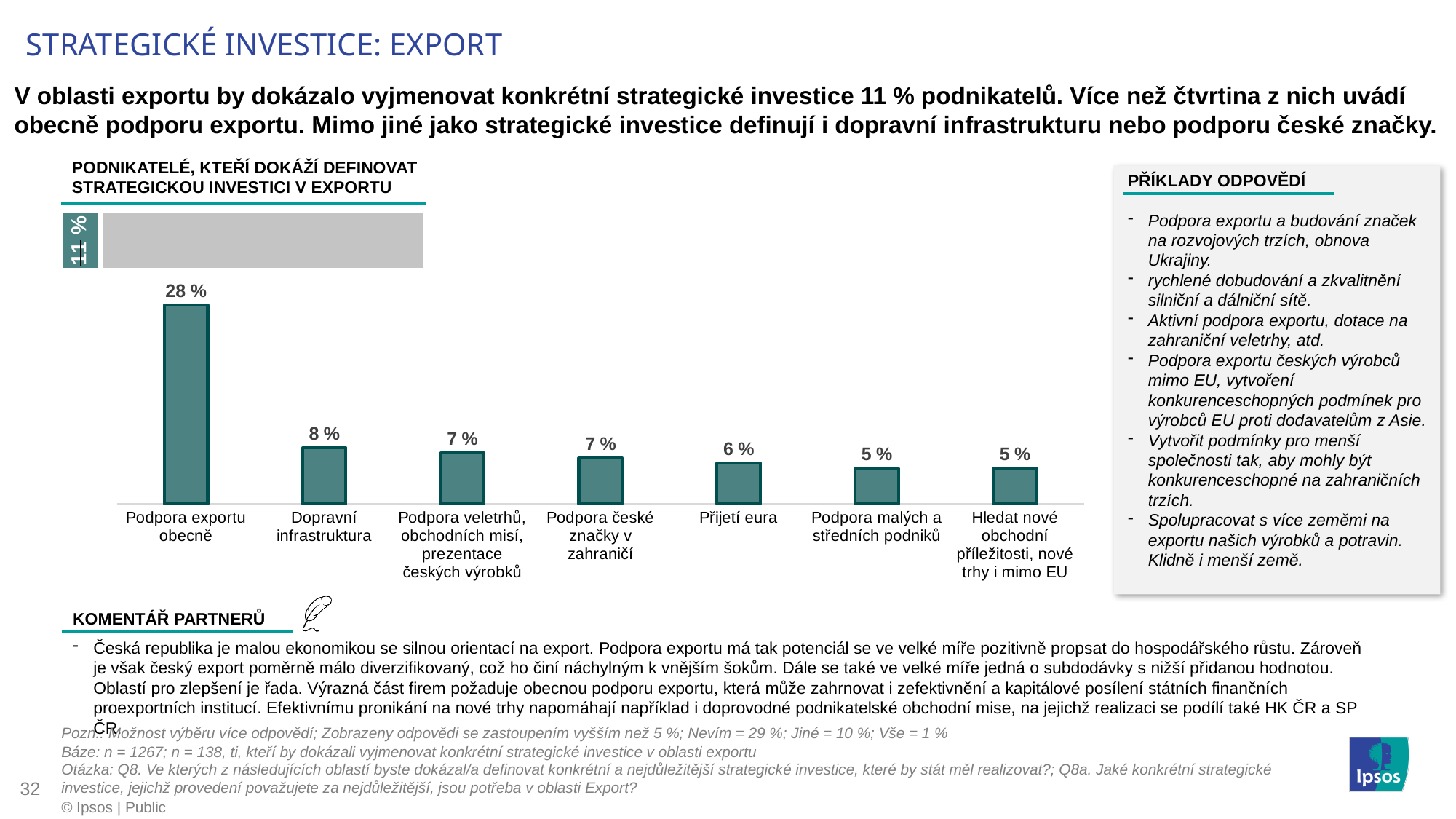
Which category has the highest value? Podpora exportu obecně What is the value for "Podpora české značky v zahraničí"? 7 % What percentage is shown in the small bar above the chart, labelled "PODNIKATELÉ, KTEŘÍ DOKÁŽÍ DEFINOVAT STRATEGICKOU INVESTICI V EXPORTU"? 11 % What is the value for "Podpora malých a středních podniků"? 5 % What is the value for "Podpora exportu obecně"? 28 % Do the values rise or fall from left to right along the x axis? Fall What is the value for "Dopravní infrastruktura"? 8 % What kind of chart is used to show the categories? Bar chart What is the difference between "Podpora exportu obecně" and "Dopravní infrastruktura"? 20 % What is the value for "Přijetí eura"? 6 % Which is larger: "Dopravní infrastruktura" or "Přijetí eura"? Dopravní infrastruktura How many categories are shown in the bar chart? 7